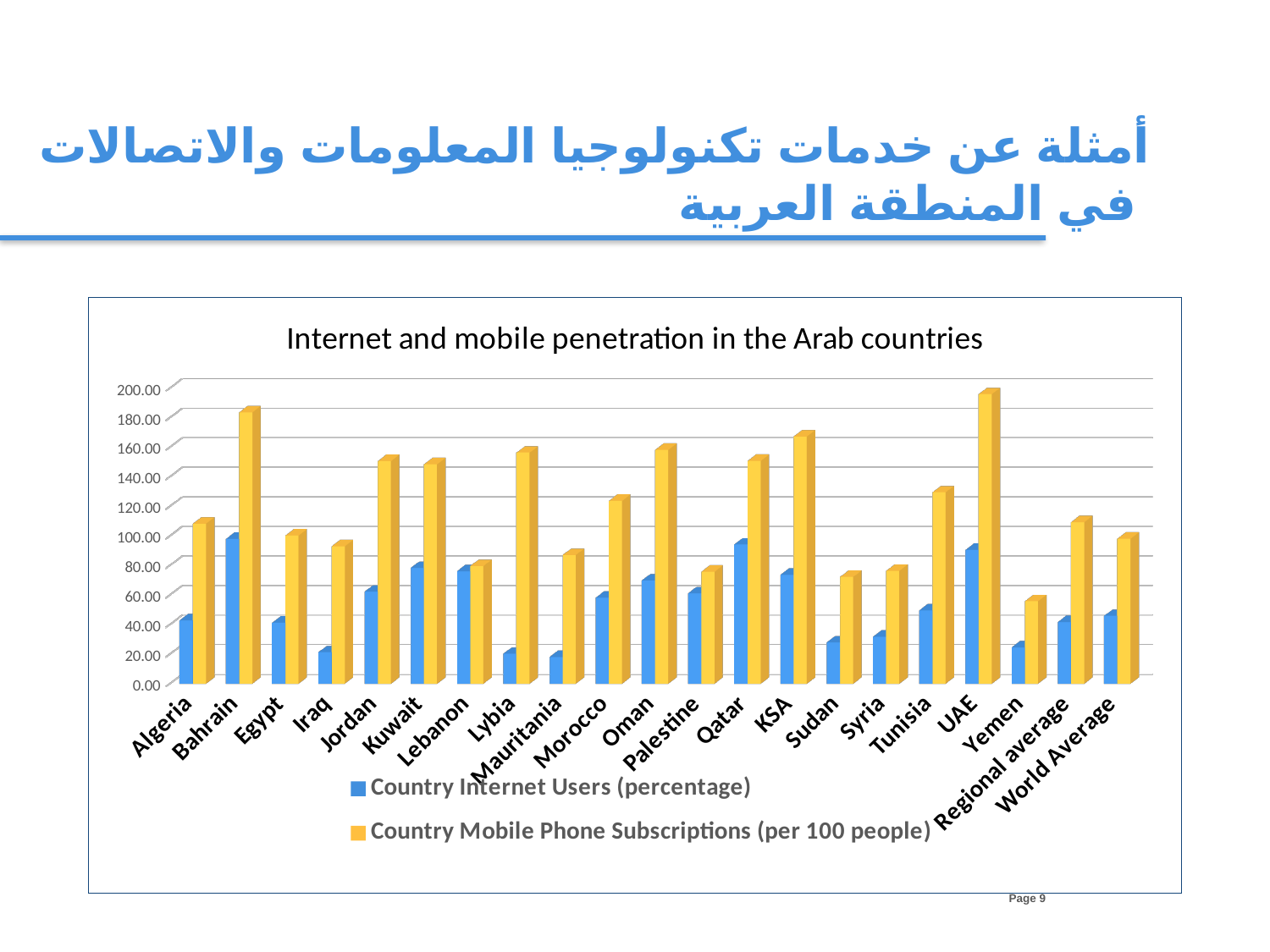
How many series does the legend list? 2 Which category has the lowest value for Country Mobile Phone Subscriptions (per 100 people)? Yemen How many categories are shown on the x axis? 21 Is the value for Bahrain in Country Mobile Phone Subscriptions (per 100 people) greater or less than 160? greater Is the value for Sudan in Country Mobile Phone Subscriptions (per 100 people) greater or less than 100? less Which has a larger value for Country Internet Users (percentage), Jordan or Iraq? Jordan Which has a larger value for Country Mobile Phone Subscriptions (per 100 people), Bahrain or Egypt? Bahrain Is the value for Qatar in Country Internet Users (percentage) greater or less than 80? greater Which category has the highest value for Country Mobile Phone Subscriptions (per 100 people)? UAE What is the title of the chart? Internet and mobile penetration in the Arab countries What type of chart is shown on the slide? bar chart